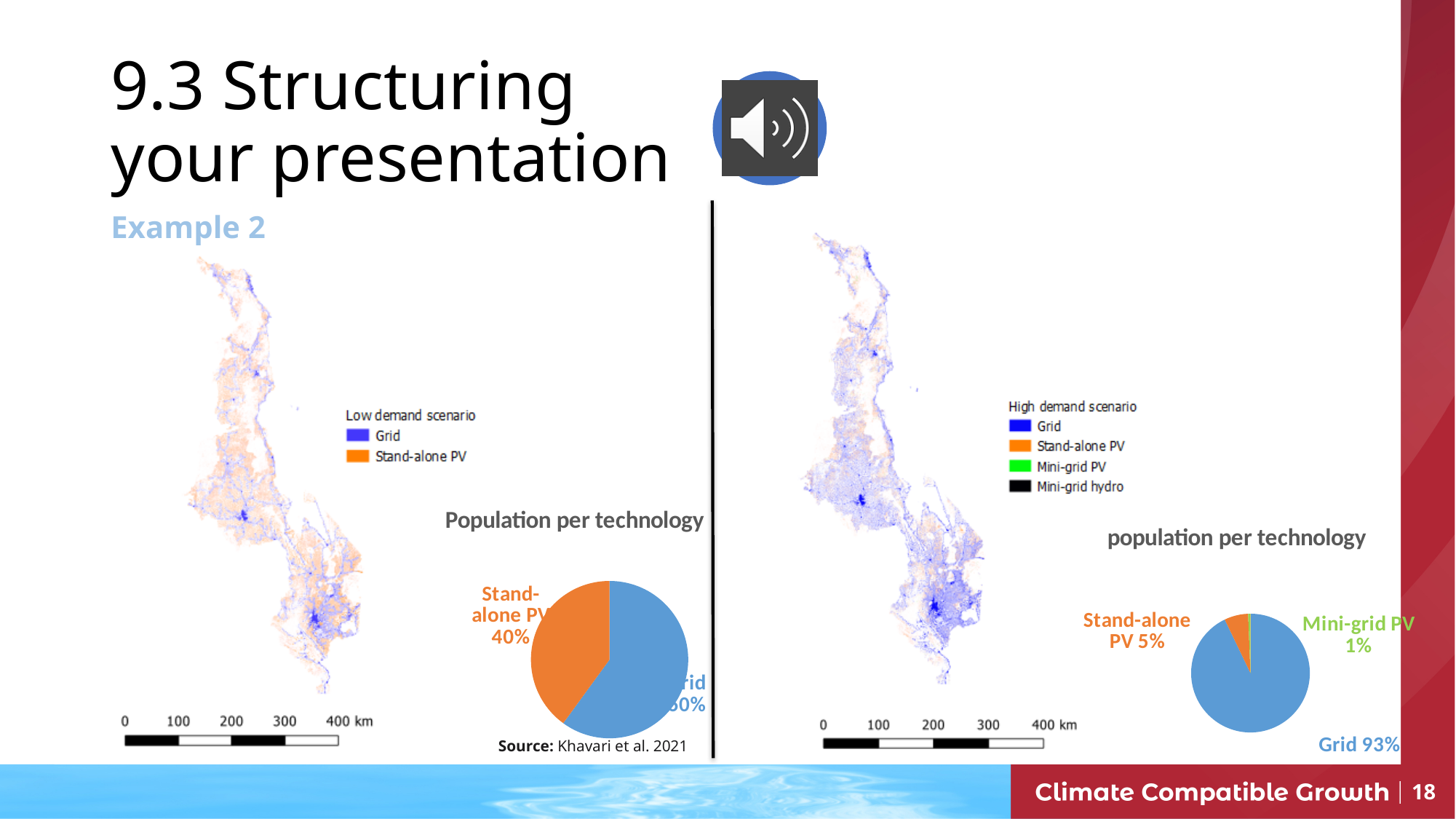
In the right 'population per technology' pie chart, which is larger, Stand-alone PV or Mini-grid PV? Stand-alone PV In the right 'population per technology' pie chart, which labelled technology has the smallest slice? Mini-grid PV In the left 'Population per technology' pie chart, what share is labelled for Stand-alone PV? 40% In the right 'population per technology' pie chart, how many percentage points larger is Grid than Stand-alone PV? 88 percentage points In the right 'population per technology' pie chart, what share is labelled for Stand-alone PV? 5% In the right 'population per technology' pie chart, what share is labelled for Grid? 93% What kind of chart is the left 'Population per technology' chart? Pie chart What kind of chart is the right 'population per technology' chart? Pie chart In the left 'Population per technology' pie chart, which slice is larger, Grid or Stand-alone PV? Grid In the right 'population per technology' pie chart, which technology has the largest slice? Grid In the right 'population per technology' pie chart, what share is labelled for Mini-grid PV? 1% In the left 'Population per technology' pie chart, which technology has the largest slice? Grid